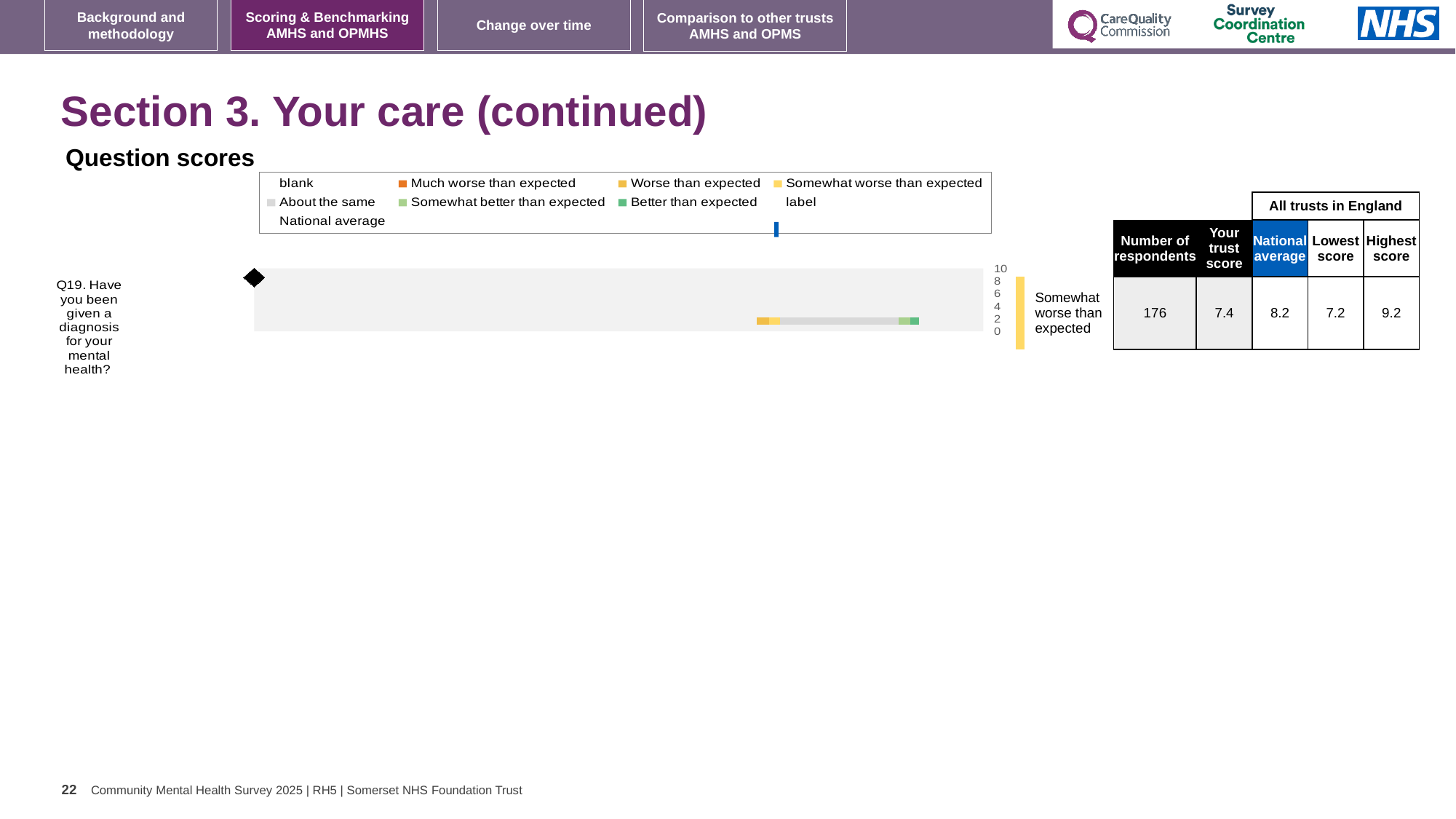
Which is larger for Q19: the trust score or the national average? national average What is the highest score among all trusts in England for Q19? 9.2 What is the difference between the national average and the trust score for Q19? 0.8 What rating label is shown next to the Q19 bar? Somewhat worse than expected What is the trust's score for Q19 according to the table? 7.4 What is the national average score for Q19? 8.2 Which question is plotted in the 'Question scores' chart? Q19. Have you been given a diagnosis for your mental health? What is the difference between the highest and lowest scores for Q19 across all trusts in England? 2.0 How many questions are plotted in the 'Question scores' chart? 1 What kind of chart is shown under 'Question scores'? bar chart What is the lowest score among all trusts in England for Q19? 7.2 How many respondents answered Q19? 176